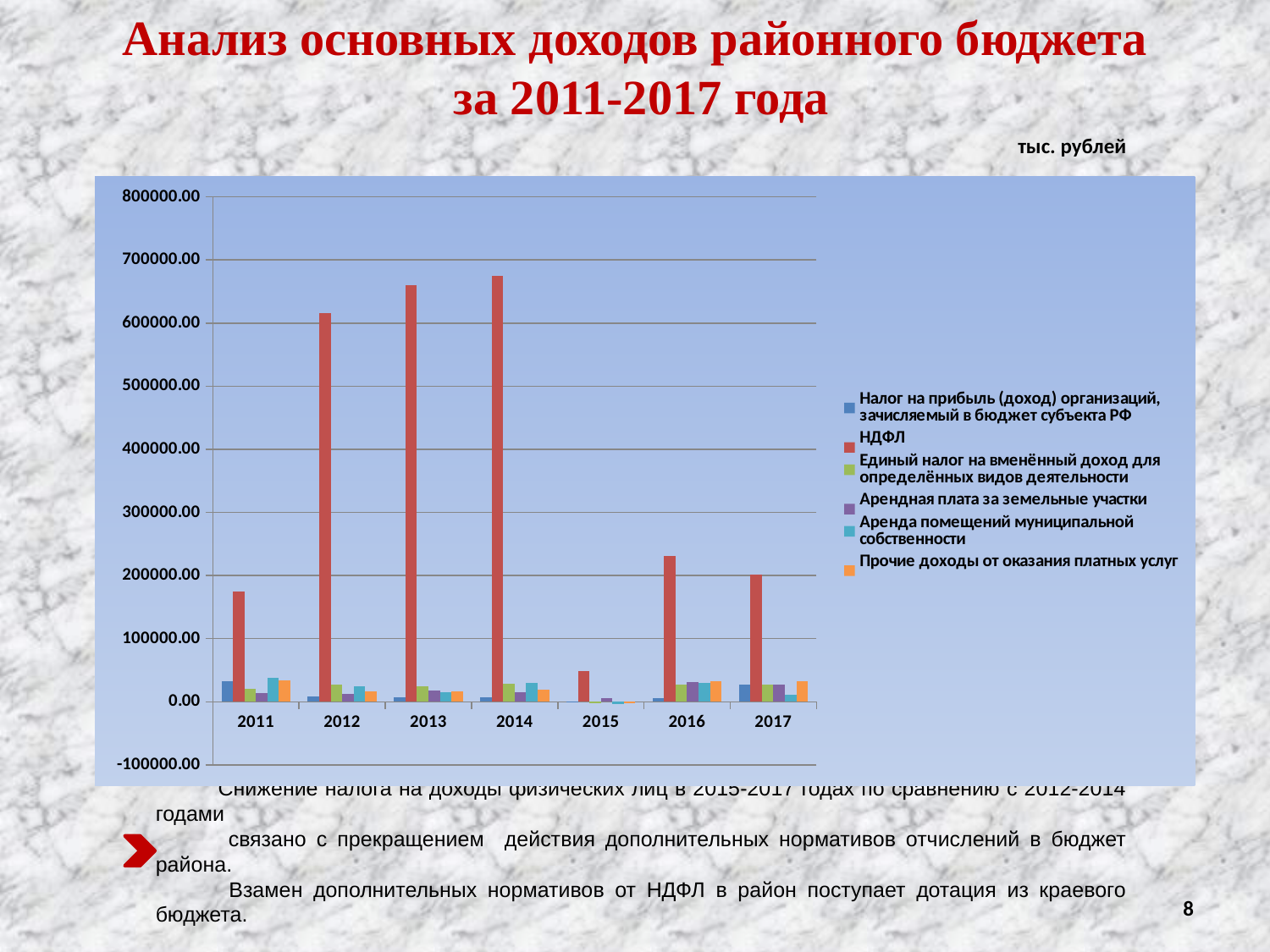
Does the НДФЛ value rise or fall from 2014 to 2015? fall Is the НДФЛ value for 2011 greater or less than 200000.00? less How many series does the chart legend list? 6 Is the НДФЛ value for 2012 greater or less than 500000.00? greater Is the НДФЛ value for 2015 greater or less than 100000.00? less What unit is indicated above the chart? тыс. рублей In which year is the НДФЛ value the lowest? 2015 Which is larger, the НДФЛ value for 2012 or for 2016? 2012 How many years are shown along the x axis of the chart? 7 What kind of chart is shown on the slide? bar chart What is the title of the slide containing the chart? Анализ основных доходов районного бюджета за 2011-2017 года